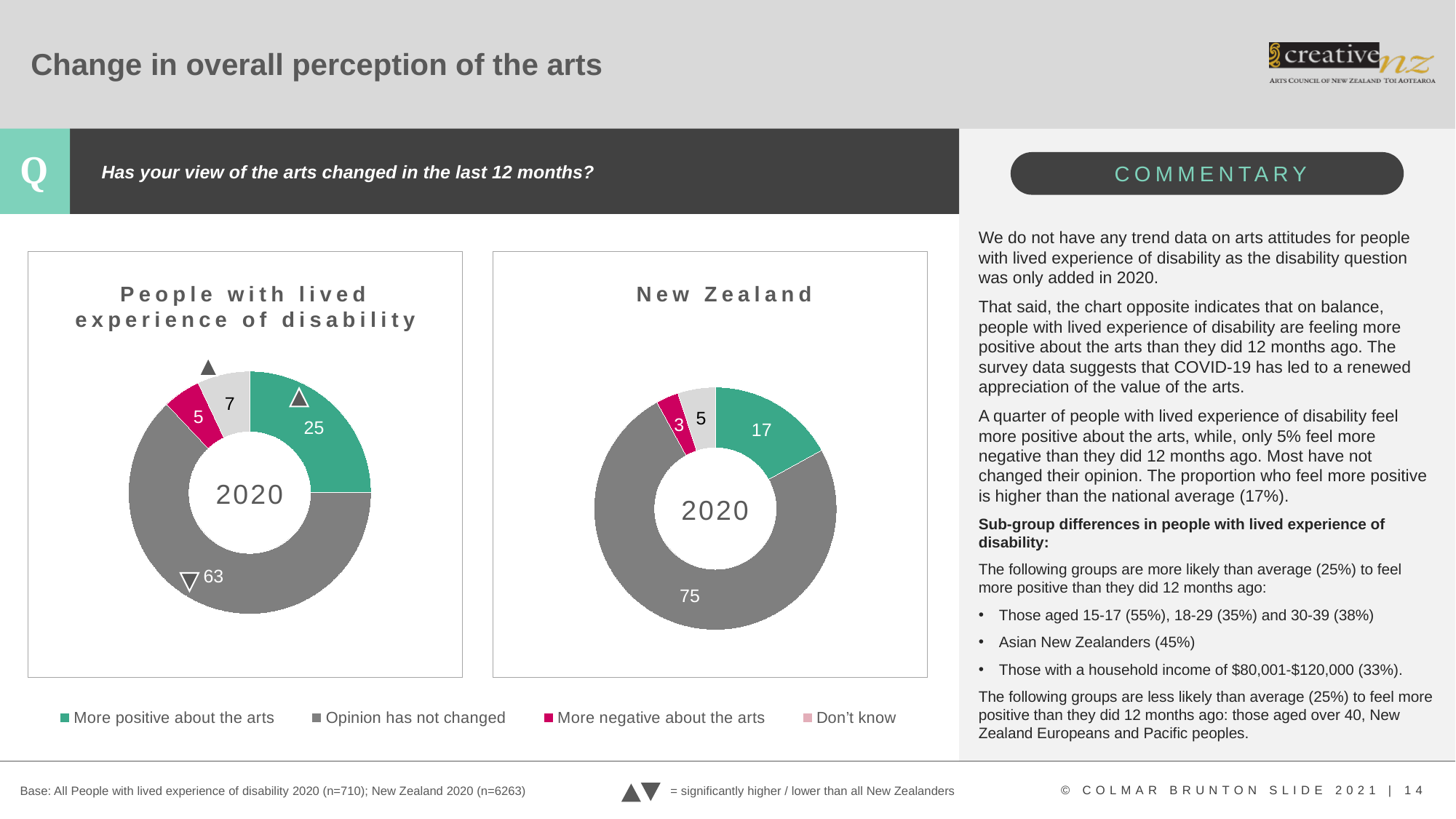
In the 'New Zealand' chart, which category has the smallest share? More negative about the arts What is the difference between the 'More positive about the arts' value in the 'People with lived experience of disability' chart and the same value in the 'New Zealand' chart? 8 In the 'People with lived experience of disability' chart, what is the difference between 'Opinion has not changed' and 'More positive about the arts'? 38 In the 'People with lived experience of disability' chart, what is the value for 'More positive about the arts'? 25 In the 'New Zealand' chart, what is the value for 'More negative about the arts'? 3 What type of chart is the 'New Zealand' chart? Doughnut (pie) chart In the 'New Zealand' chart, what is the value for 'Opinion has not changed'? 75 How many categories does the legend list for the charts? 4 In the 'People with lived experience of disability' chart, what is the value for 'Don't know'? 7 Which chart has the larger value for 'Opinion has not changed', 'People with lived experience of disability' or 'New Zealand'? New Zealand In the 'People with lived experience of disability' chart, which category has the largest share? Opinion has not changed What year is shown in the centre of the 'People with lived experience of disability' chart? 2020